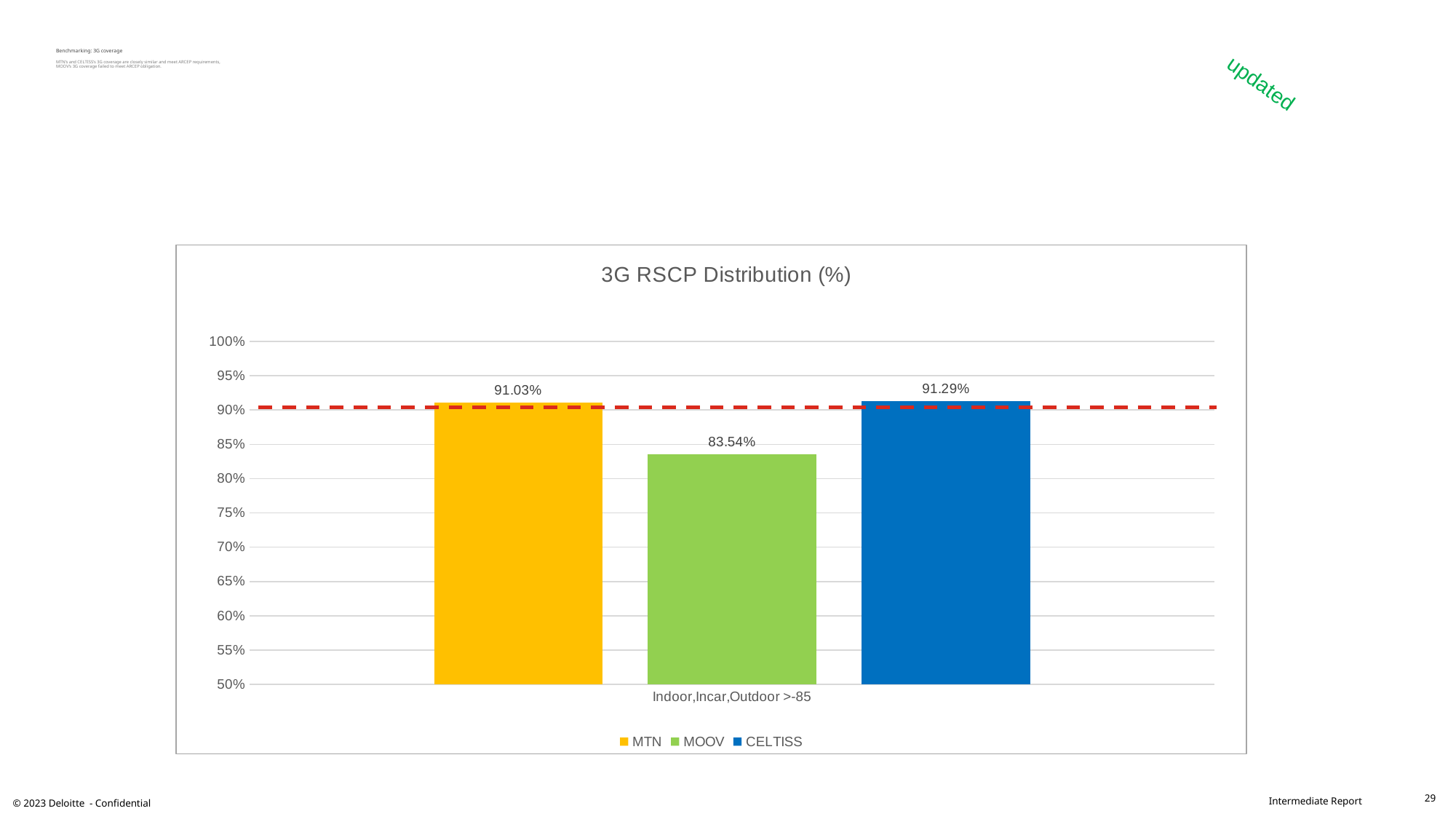
Which is larger in the 3G RSCP Distribution (%) chart, the value for MTN or the value for MOOV? MTN Which operator has the highest value in the 3G RSCP Distribution (%) chart? CELTISS Which operator has the lowest value in the 3G RSCP Distribution (%) chart? MOOV Is the value for MOOV in the 3G RSCP Distribution (%) chart greater or less than 85%? less What kind of chart is the 3G RSCP Distribution (%) chart? bar chart What is the value for MOOV in the 3G RSCP Distribution (%) chart? 83.54% What is the difference between the CELTISS and MTN values in the 3G RSCP Distribution (%) chart? 0.26% What is the difference between the MTN and MOOV values in the 3G RSCP Distribution (%) chart? 7.49% What is the value for CELTISS in the 3G RSCP Distribution (%) chart? 91.29% How many series does the legend of the 3G RSCP Distribution (%) chart list? 3 What is the category label on the x axis of the 3G RSCP Distribution (%) chart? Indoor,Incar,Outdoor >-85 What is the value for MTN in the 3G RSCP Distribution (%) chart? 91.03%